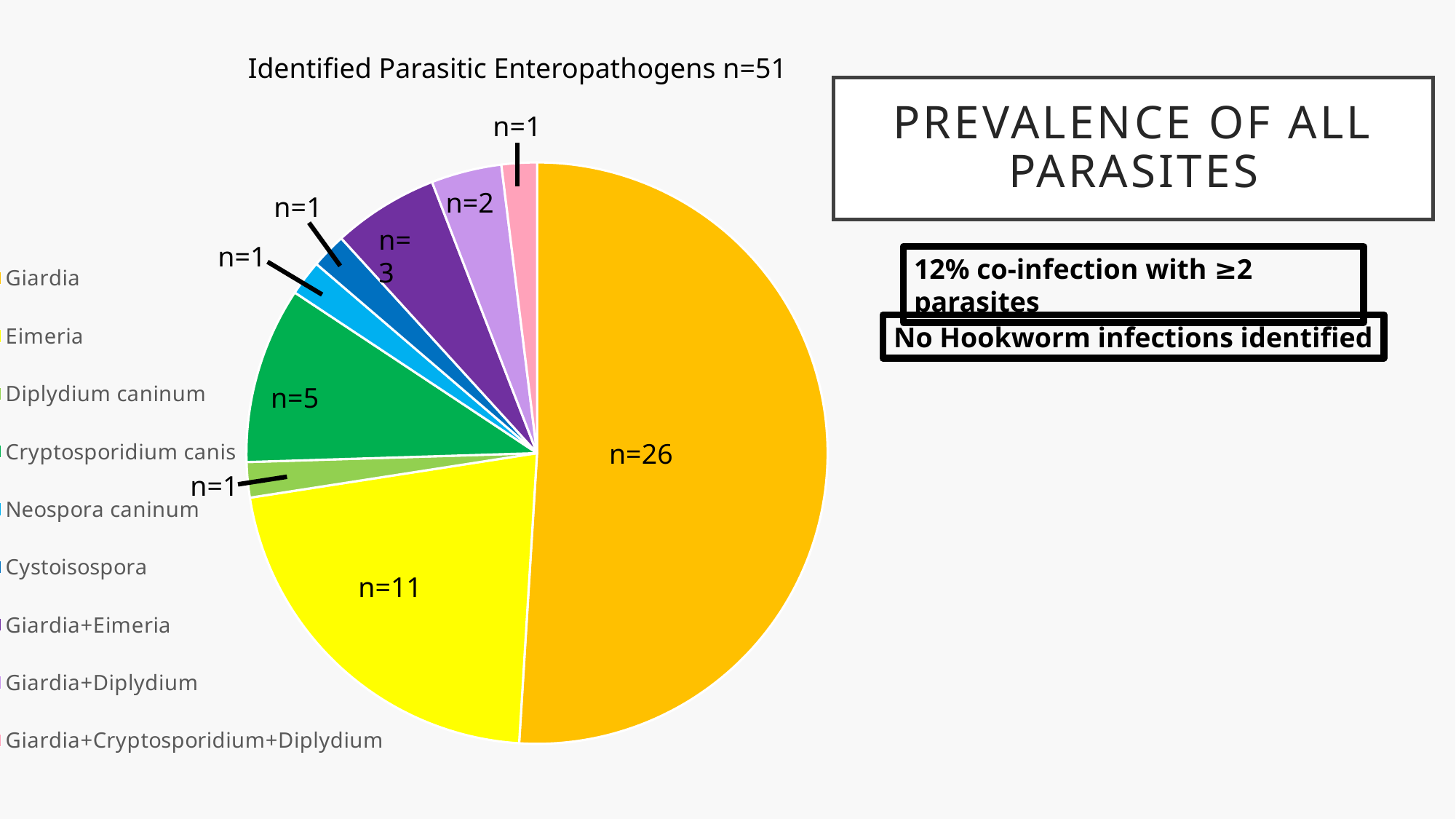
What is the value shown for Giardia+Diplydium? n=2 What is the title of the chart? Identified Parasitic Enteropathogens n=51 What is the value shown for Giardia+Eimeria? n=3 What is the difference between the values for Giardia and Eimeria? 15 Which category has the largest slice of the pie? Giardia What is the value shown for Giardia? n=26 What is the value shown for Cryptosporidium canis? n=5 What kind of chart is shown on the slide? pie chart What is the value shown for Eimeria? n=11 How many categories in the chart have a value of n=1? 4 How many categories does the chart's legend list? 9 Which is larger, the value for Cryptosporidium canis or the value for Giardia+Eimeria? Cryptosporidium canis